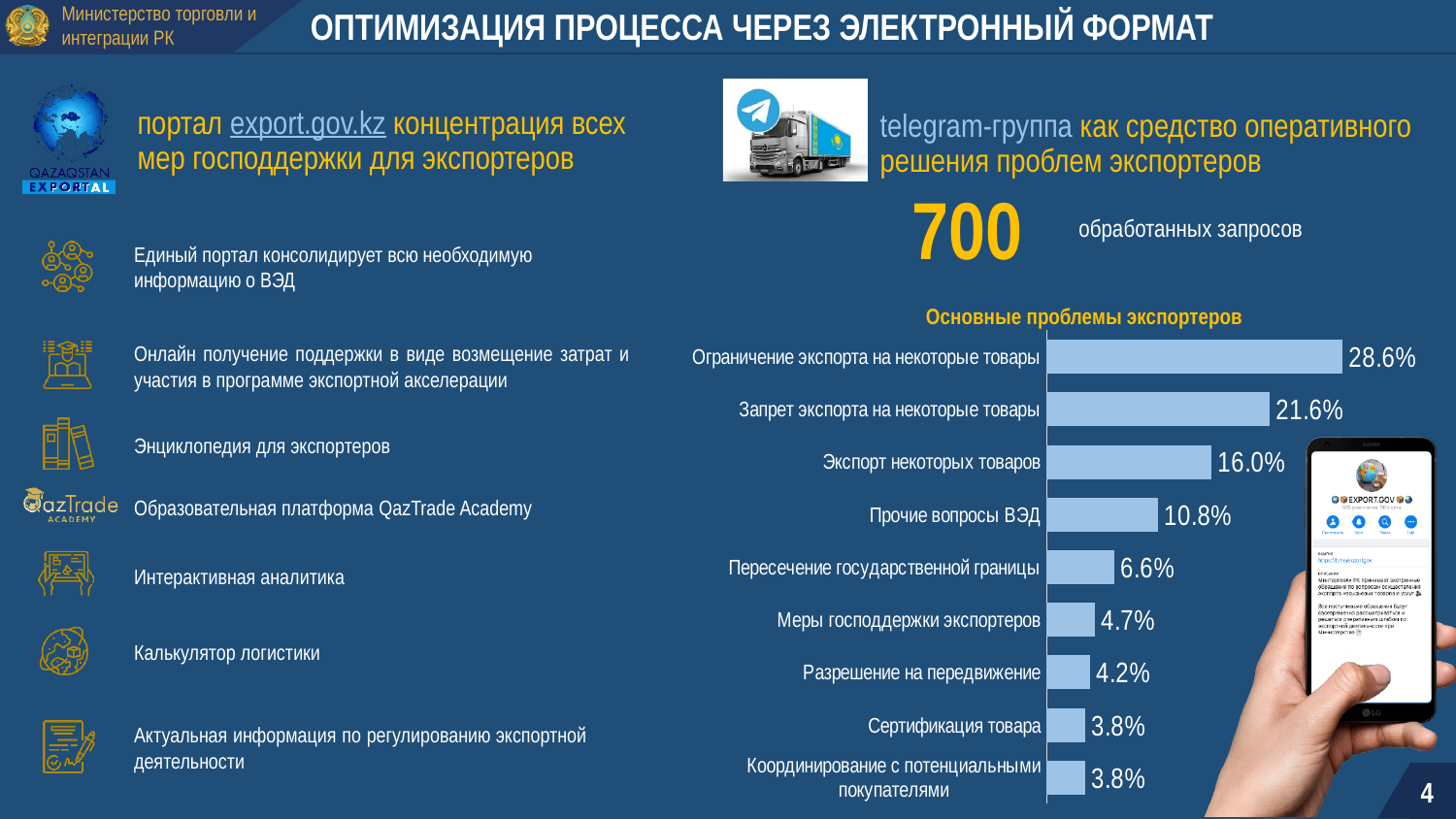
What is the value for 'Запрет экспорта на некоторые товары'? 21.6% What is the difference between the values for 'Ограничение экспорта на некоторые товары' and 'Запрет экспорта на некоторые товары'? 7.0% What is the value for 'Меры господдержки экспортеров'? 4.7% What is the difference between the values for 'Экспорт некоторых товаров' and 'Прочие вопросы ВЭД'? 5.2% What kind of chart is 'Основные проблемы экспортеров'? Bar chart What is the title of the chart on the slide? Основные проблемы экспортеров How many categories are shown in the chart 'Основные проблемы экспортеров'? 9 What is the value for 'Сертификация товара'? 3.8% What is the value for 'Ограничение экспорта на некоторые товары' in the chart 'Основные проблемы экспортеров'? 28.6% Which is larger: the value for 'Пересечение государственной границы' or the value for 'Разрешение на передвижение'? Пересечение государственной границы What is the value for 'Прочие вопросы ВЭД'? 10.8% Which category has the highest value in the chart 'Основные проблемы экспортеров'? Ограничение экспорта на некоторые товары